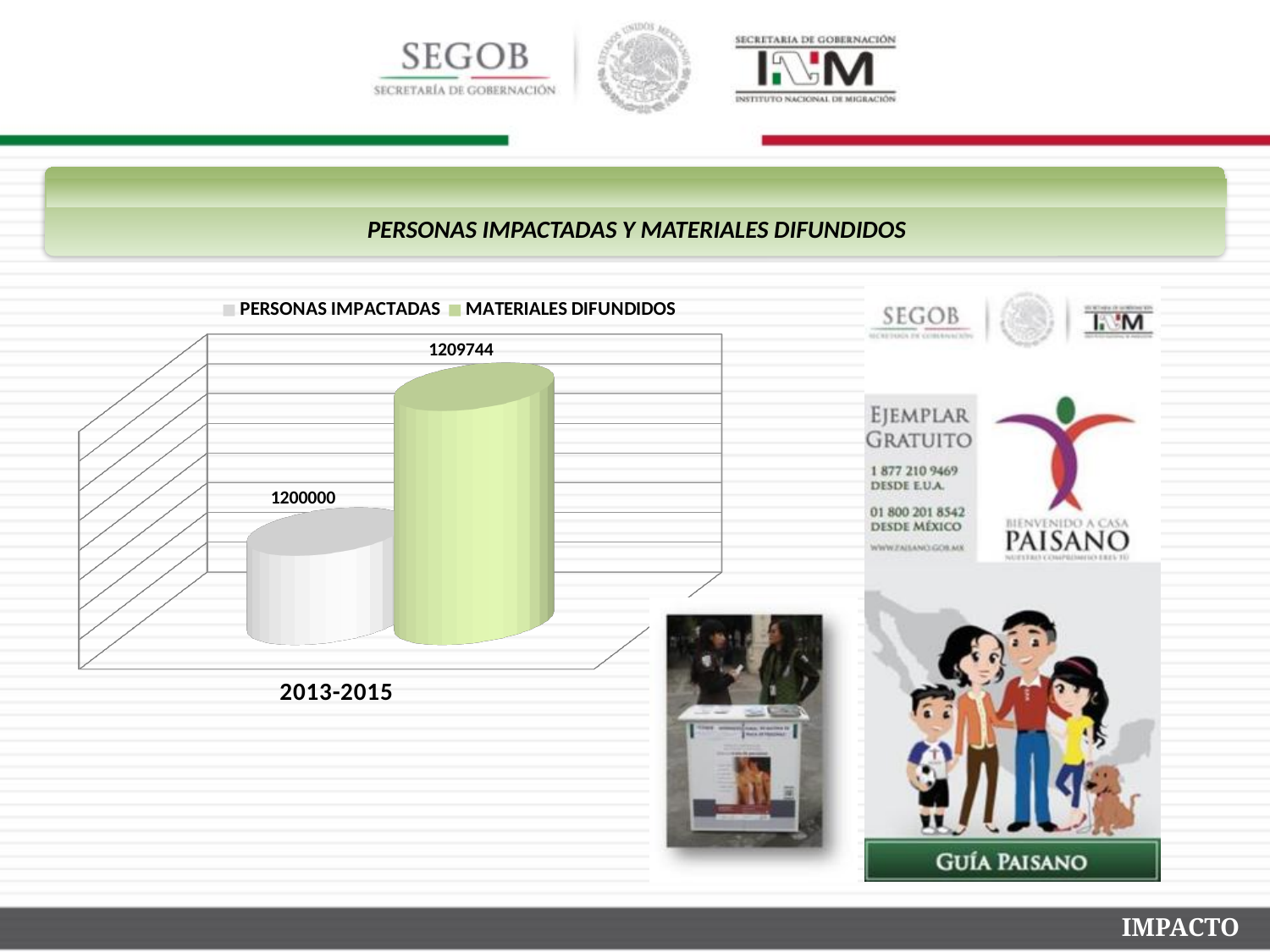
What is the category label shown on the x axis of the chart? 2013-2015 What is the value for PERSONAS IMPACTADAS in the chart? 1200000 What is the title shown above the chart on the slide? PERSONAS IMPACTADAS Y MATERIALES DIFUNDIDOS How many series does the chart legend list? 2 How many categories are shown on the x axis of the chart? 1 What is the difference between MATERIALES DIFUNDIDOS and PERSONAS IMPACTADAS? 9744 Is the value for MATERIALES DIFUNDIDOS larger or smaller than the value for PERSONAS IMPACTADAS? larger Which series has the lower value in the chart? PERSONAS IMPACTADAS Which series has the higher value in the chart? MATERIALES DIFUNDIDOS What is the value for MATERIALES DIFUNDIDOS in the chart? 1209744 What kind of chart is shown on the slide? bar chart